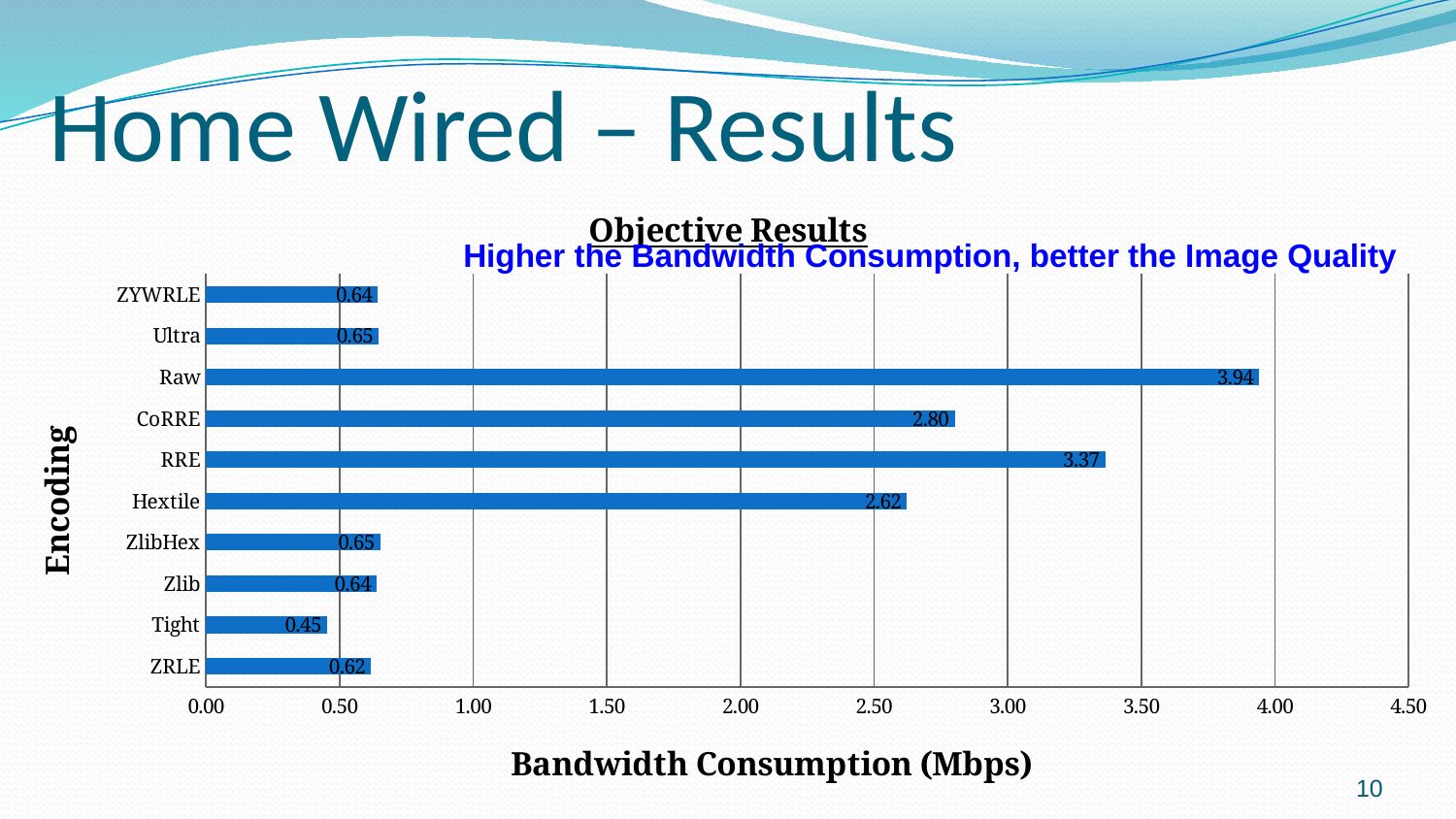
Which encoding has the highest bandwidth consumption? Raw What is the title of the chart? Objective Results How many encodings are shown in the chart? 10 What is the label of the horizontal axis? Bandwidth Consumption (Mbps) Is the bandwidth consumption for RRE greater or less than 3.00? greater What is the bandwidth consumption for Tight encoding? 0.45 What is the bandwidth consumption for Hextile encoding? 2.62 What is the bandwidth consumption for Raw encoding? 3.94 What is the difference in bandwidth consumption between RRE and CoRRE? 0.57 Which encoding has the lowest bandwidth consumption? Tight Which has higher bandwidth consumption, CoRRE or Hextile? CoRRE What type of chart is shown on the slide? Bar chart